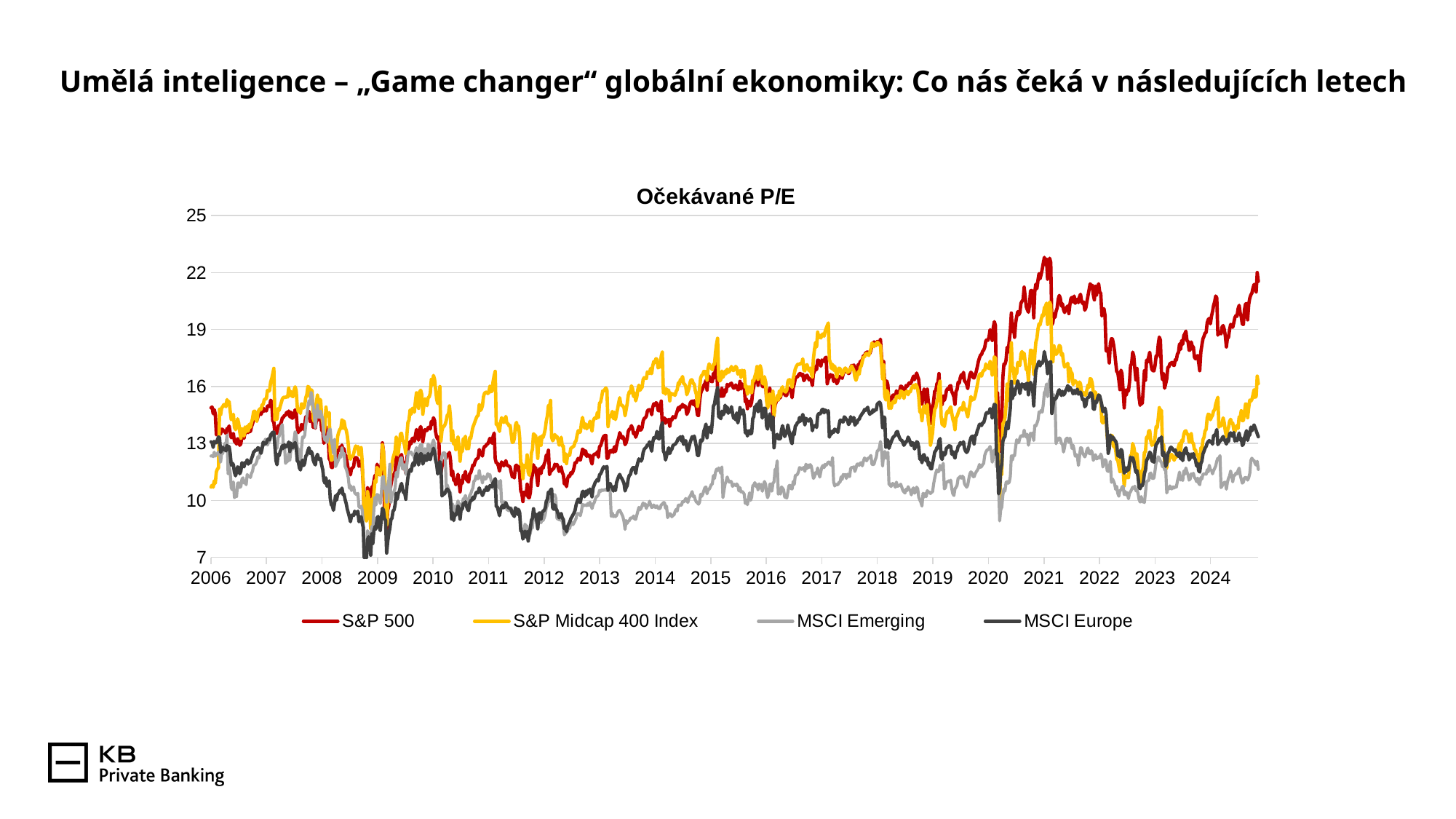
Which series has the highest value at the right end of the chart (end of 2024)? S&P 500 Which colour is used for the S&P 500 line? red At its lowest point around 2009, is the value for MSCI Europe greater or less than 10? less How many series does the legend of the chart list? 4 What is the title of the chart? Očekávané P/E At the right end of the chart, is the value for MSCI Emerging greater or less than 16? less What kind of chart is shown on the slide? line chart Does the S&P 500 line rise or fall from its low in 2022 to the end of 2024? rise At the right end of the chart, which is larger: the value for S&P 500 or the value for MSCI Emerging? S&P 500 At the right end of the chart, is the value for S&P 500 greater or less than 19? greater How many year labels are shown on the x axis? 19 Which series has the lowest value at the right end of the chart (end of 2024)? MSCI Emerging